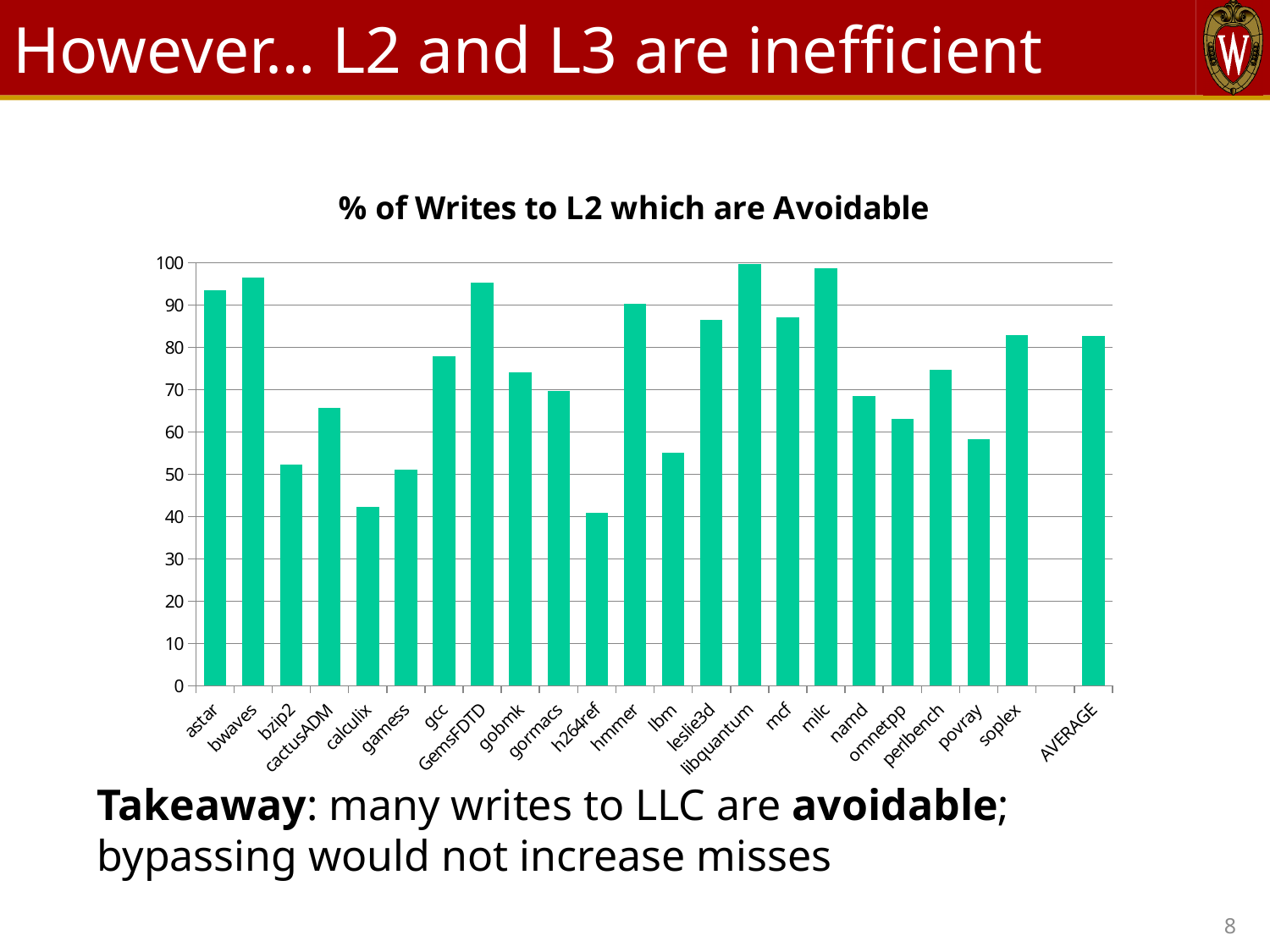
Is the value for GemsFDTD greater or less than 90? greater What is the title of the chart? % of Writes to L2 which are Avoidable Is the value for h264ref greater or less than 50? less Is the value for astar greater or less than 90? greater What kind of chart is shown on the slide? bar chart How many bars (categories) are plotted in the chart? 23 Which has a larger value, lbm or leslie3d? leslie3d Which has a larger value, calculix or gcc? gcc